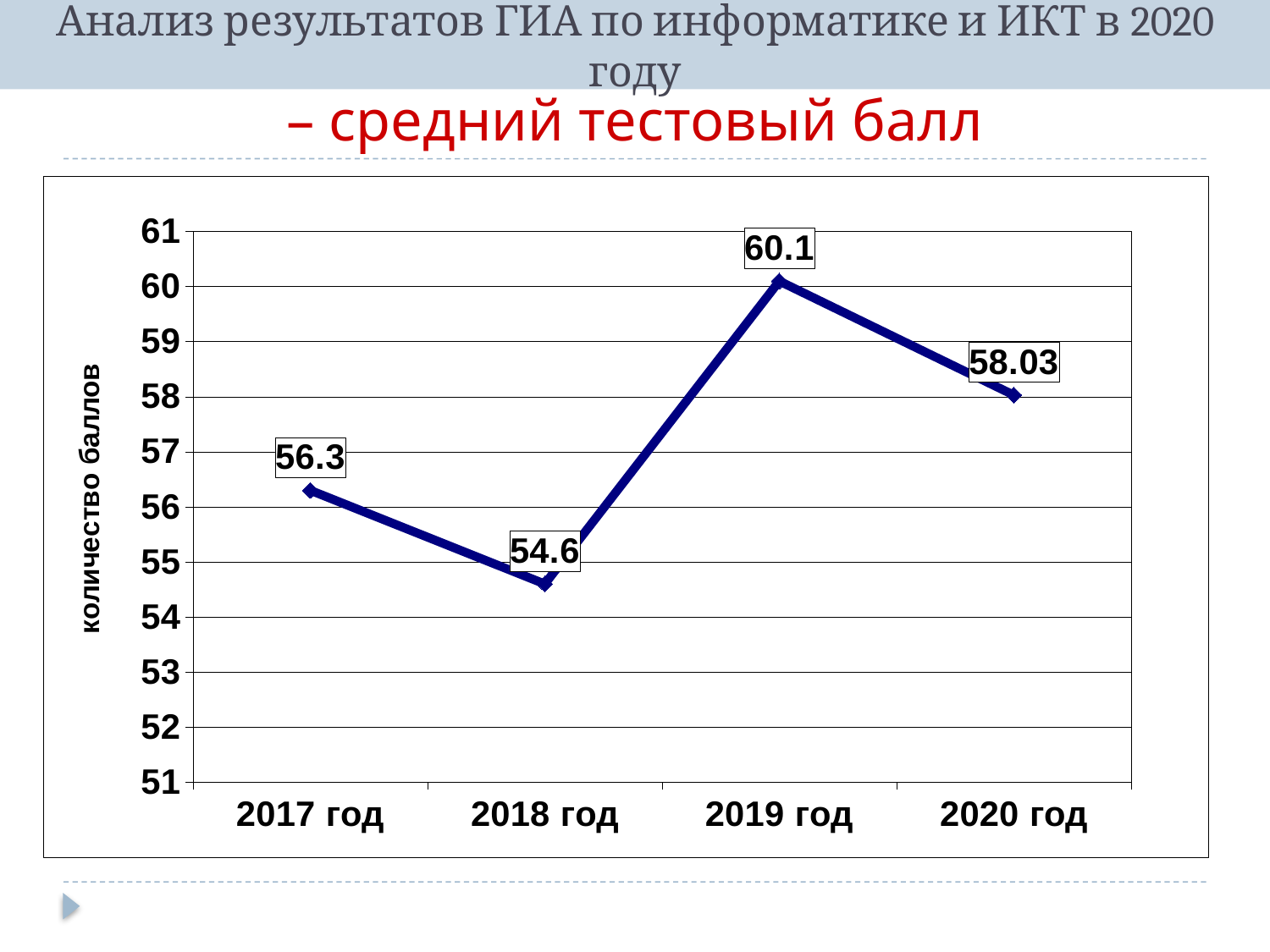
Is the value for 2018 год greater or less than 55? less What kind of chart is shown on the slide? line chart What is the average test score for 2019 год? 60.1 What is the average test score for 2017 год? 56.3 What is the difference between the values for 2019 год and 2018 год? 5.5 What is the label of the vertical axis? количество баллов Which is larger, the value for 2020 год or the value for 2017 год? 2020 год What is the value shown for 2020 год? 58.03 Which year has the lowest average test score? 2018 год How many years are plotted on the chart? 4 Which year has the highest average test score? 2019 год What is the difference between the values for 2017 год and 2018 год? 1.7